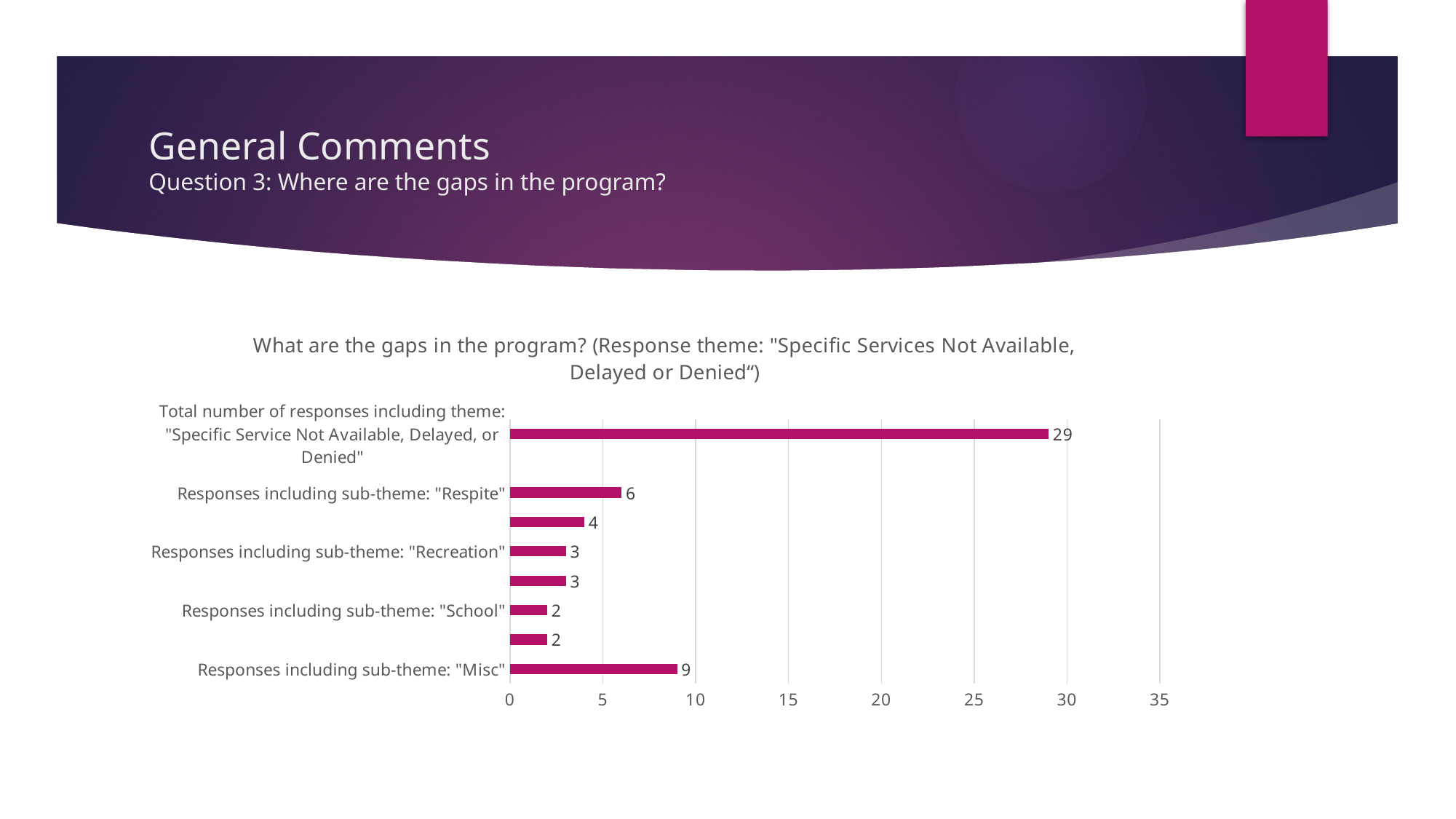
What kind of chart is shown on the slide? Bar chart Is the total number of responses including the theme greater or less than 25? greater Which has more responses: the "Recreation" sub-theme or the "School" sub-theme? Recreation How many responses include the sub-theme "School"? 2 How many responses include the sub-theme "Recreation"? 3 Which category has the highest value in the chart? Total number of responses including theme: "Specific Service Not Available, Delayed, or Denied" What is the total number of responses including the theme "Specific Service Not Available, Delayed, or Denied"? 29 What is the highest value shown on the horizontal axis of the chart? 35 What is the difference between the "Misc" sub-theme responses and the "Respite" sub-theme responses? 3 How many responses include the sub-theme "Misc"? 9 How many responses include the sub-theme "Respite"? 6 How many bars are plotted in the chart? 8